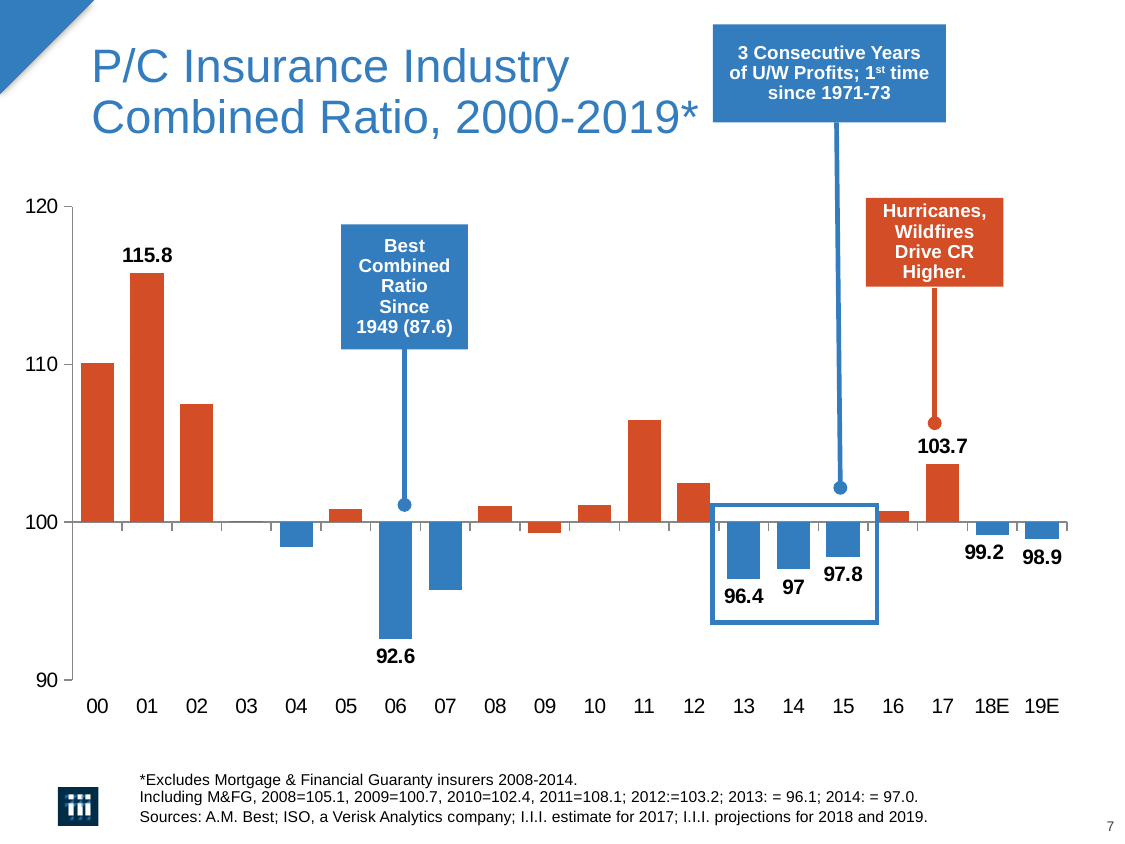
What is the combined ratio for 2006 (06)? 92.6 Is the combined ratio for 2007 (07) greater or less than 100? less How many years are shown on the x axis? 20 Which year has the lowest combined ratio? 06 What is the combined ratio for 2001 (01)? 115.8 What is the difference between the combined ratio in 2017 (17) and in 2018E? 4.5 What is the difference between the combined ratio in 2001 (01) and in 2006 (06)? 23.2 Which year has the highest combined ratio? 01 Which year has the larger combined ratio, 2014 (14) or 2015 (15)? 15 What is the combined ratio for 2013 (13)? 96.4 What is the combined ratio for 2017 (17)? 103.7 What type of chart is shown on the slide? bar chart